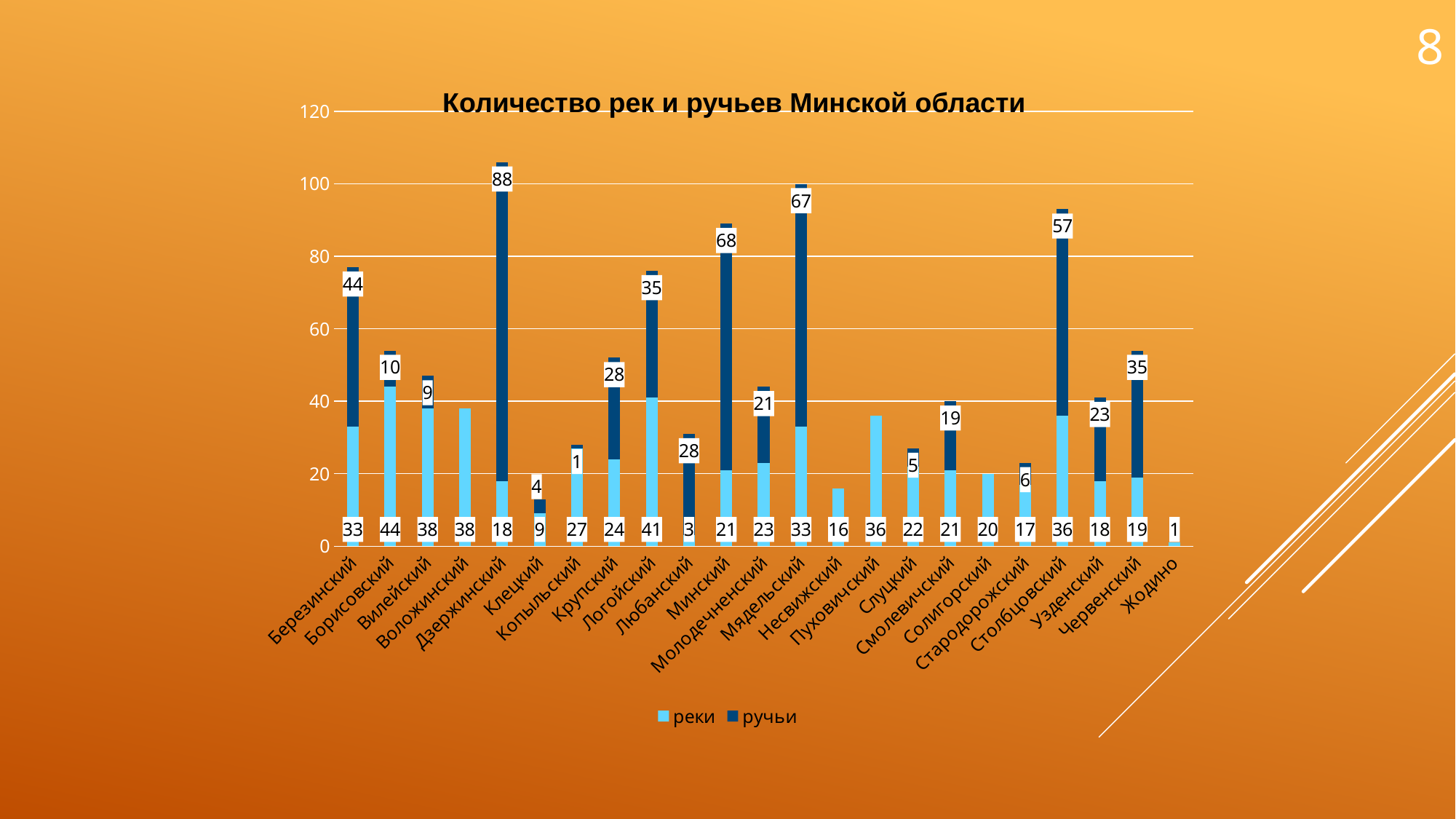
What is the total of the stacked bar for Дзержинский? 106 What kind of chart is shown on the slide? Stacked bar chart Which category has the highest value for ручьи? Дзержинский What is the title of the chart? Количество рек и ручьев Минской области How many categories are shown on the x axis? 23 What is the value of ручьи for Минский? 68 Which has a larger реки value, Борисовский or Пуховичский? Борисовский What is the total of the stacked bar for Мядельский? 100 Which category has the lowest value for реки? Жодино What is the value of реки for Логойский? 41 What is the difference between the ручьи values for Дзержинский and Минский? 20 How many series does the legend list? 2